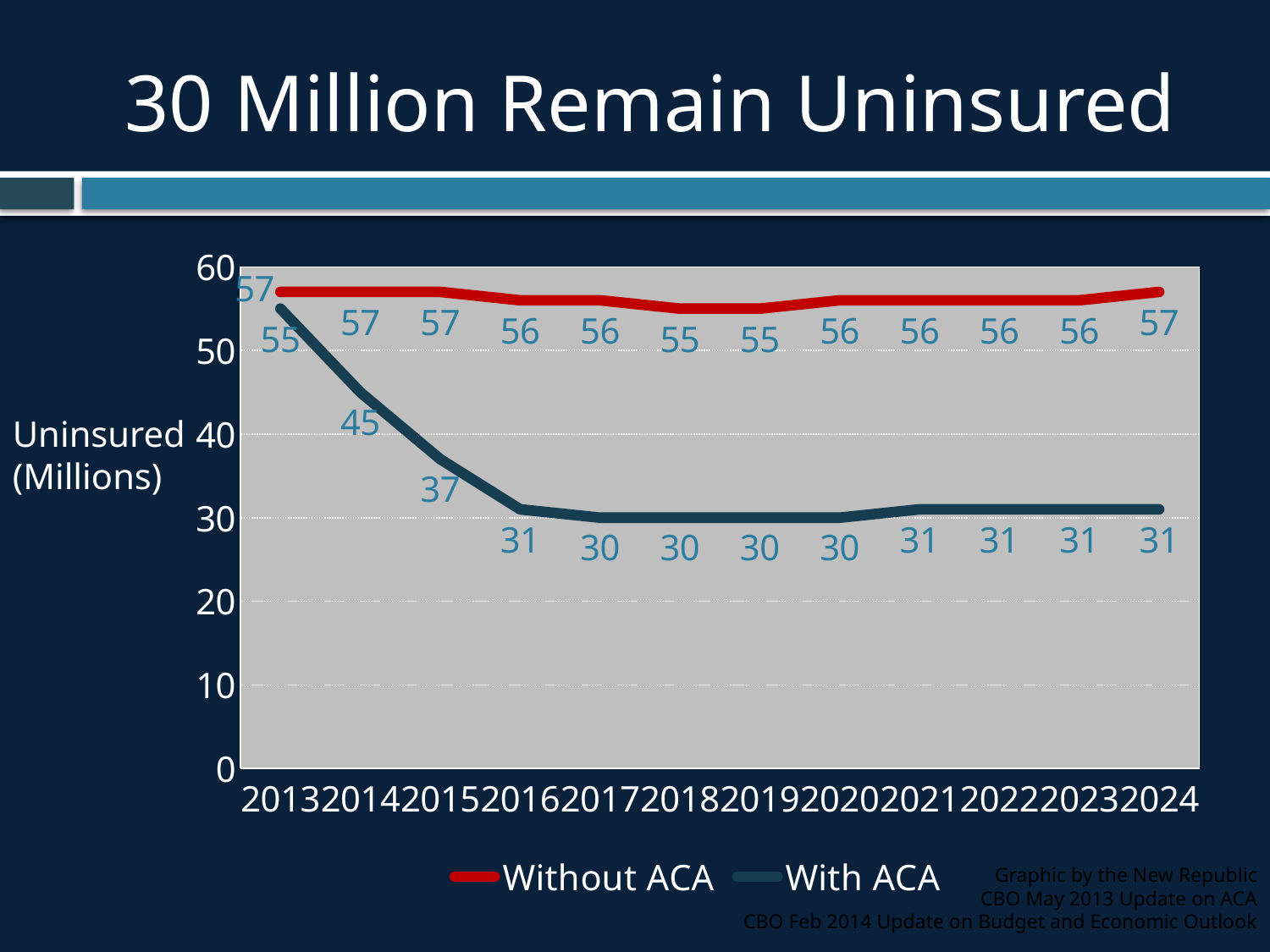
In which year is the With ACA value highest? 2013 What is the value for With ACA in 2017? 30 What type of chart is shown on the slide? line chart How many series does the legend list? 2 What is the title of the chart? 30 Million Remain Uninsured What colour is the Without ACA line? red Does the With ACA line rise or fall from 2013 to 2016? fall What is the difference between the Without ACA and With ACA values in 2024? 26 How many years are plotted along the x axis? 12 What is the value for With ACA in 2014? 45 What is the value for Without ACA in 2018? 55 Which is larger in 2015, the Without ACA value or the With ACA value? Without ACA